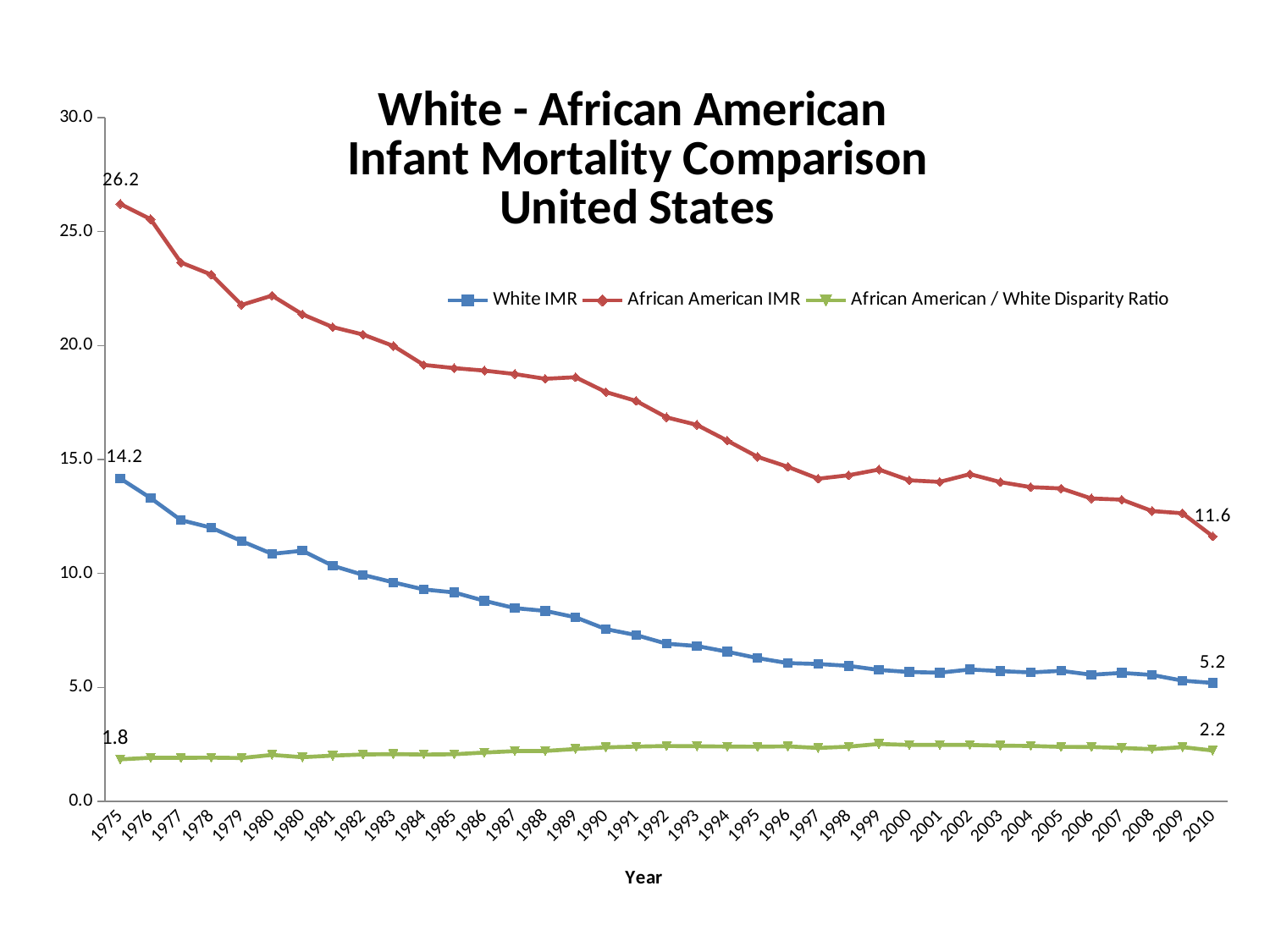
What is the White IMR value in 1975? 14.2 What is the White IMR value in 2010? 5.2 Is the White IMR value for 1990 greater or less than 10.0? less What type of chart is shown on the slide? line chart How many series does the legend list? 3 What is the African American IMR value in 1975? 26.2 Which series is higher in 2000, White IMR or African American IMR? African American IMR What is the difference between the African American IMR and the White IMR in 1975? 12.0 By how much did the White IMR fall from 1975 to 2010? 9.0 What is the African American IMR value in 2010? 11.6 Does the African American IMR rise or fall from 1975 to 2010? fall What is the African American / White Disparity Ratio in 2010? 2.2